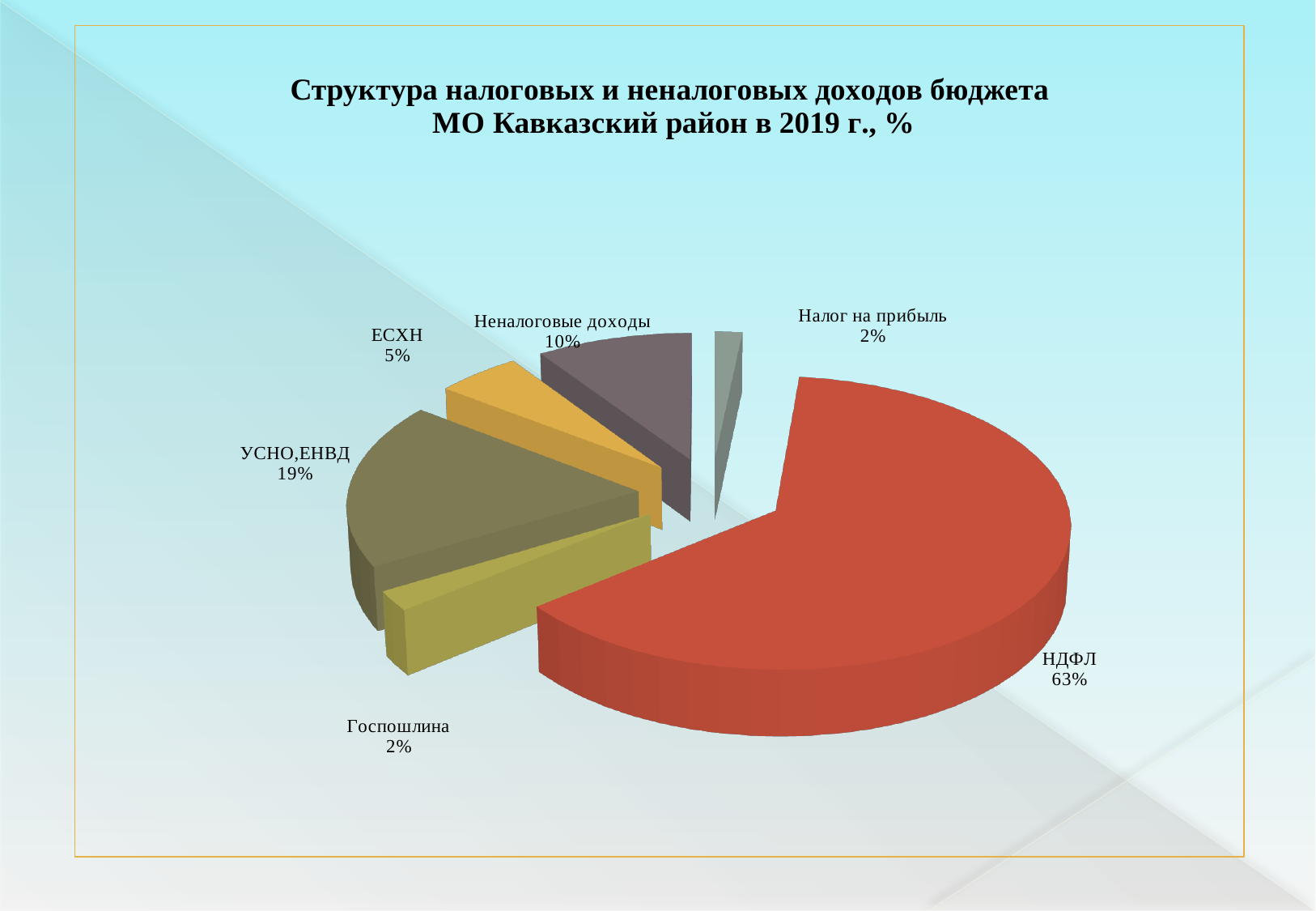
What is the value shown for Госпошлина? 2% What kind of chart is shown on the slide? pie chart What share of the pie does НДФЛ have? 63% What is the difference between the shares of НДФЛ and УСНО,ЕНВД? 44% What is the value shown for Налог на прибыль? 2% What is the value shown for Неналоговые доходы? 10% How many slices does the pie chart have? 6 Which category has the largest slice of the pie? НДФЛ Which is larger, the share of Неналоговые доходы or the share of ЕСХН? Неналоговые доходы What is the value shown for ЕСХН? 5% What is the value shown for УСНО,ЕНВД? 19% What is the title of the chart? Структура налоговых и неналоговых доходов бюджета МО Кавказский район в 2019 г., %